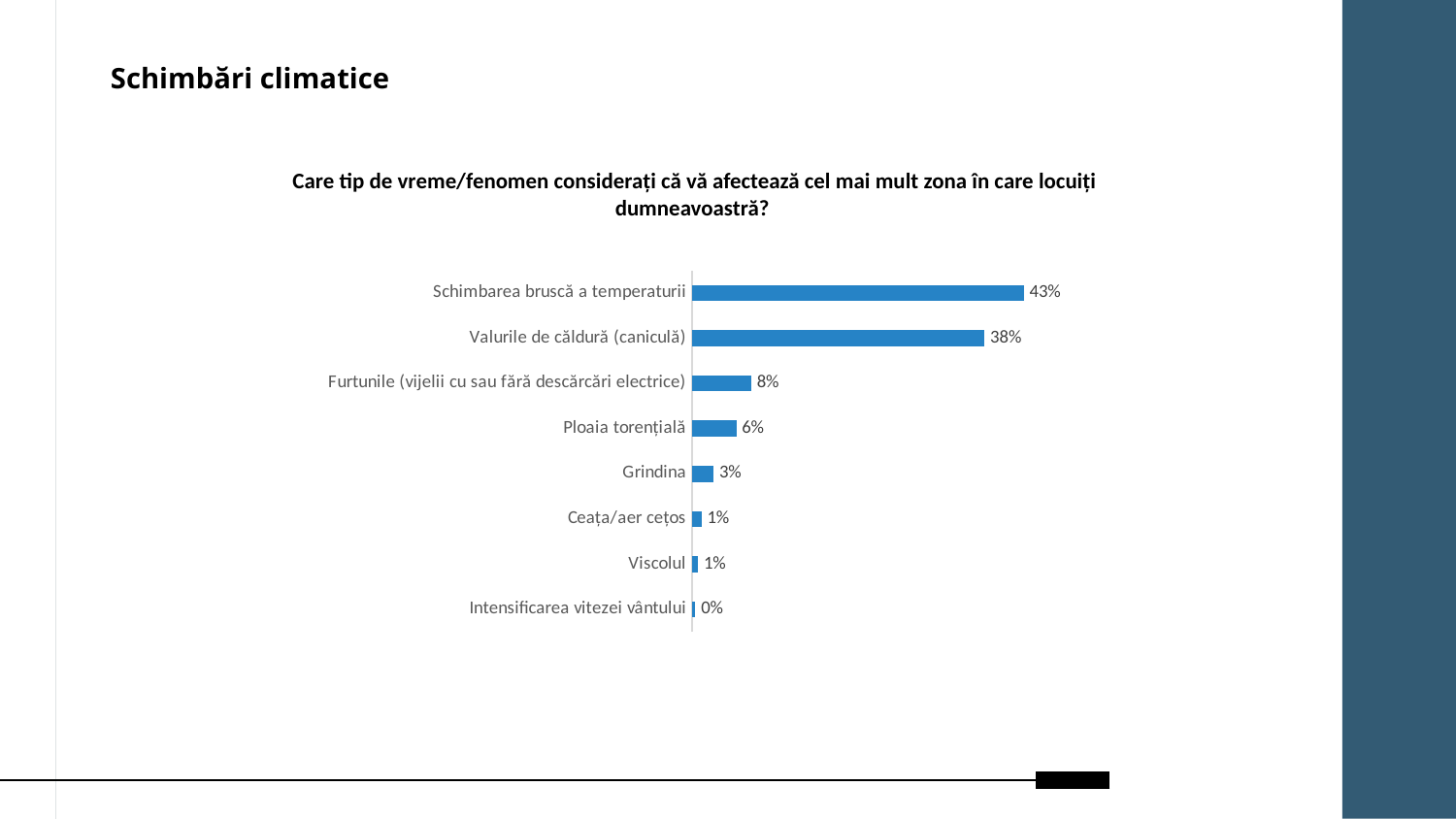
What is the title of the chart? Care tip de vreme/fenomen considerați că vă afectează cel mai mult zona în care locuiți dumneavoastră? What value is shown for "Schimbarea bruscă a temperaturii"? 43% Which is larger, the value for "Furtunile (vijelii cu sau fără descărcări electrice)" or the value for "Grindina"? Furtunile (vijelii cu sau fără descărcări electrice) How many categories are shown in the chart? 8 Which category has the lowest value? Intensificarea vitezei vântului What value is shown for "Grindina"? 3% Which category has the highest value? Schimbarea bruscă a temperaturii What is the difference between the values for "Furtunile (vijelii cu sau fără descărcări electrice)" and "Ploaia torențială"? 2% What is the difference between the values for "Schimbarea bruscă a temperaturii" and "Valurile de căldură (caniculă)"? 5% What value is shown for "Valurile de căldură (caniculă)"? 38% What kind of chart is shown on the slide? Bar chart What value is shown for "Ploaia torențială"? 6%